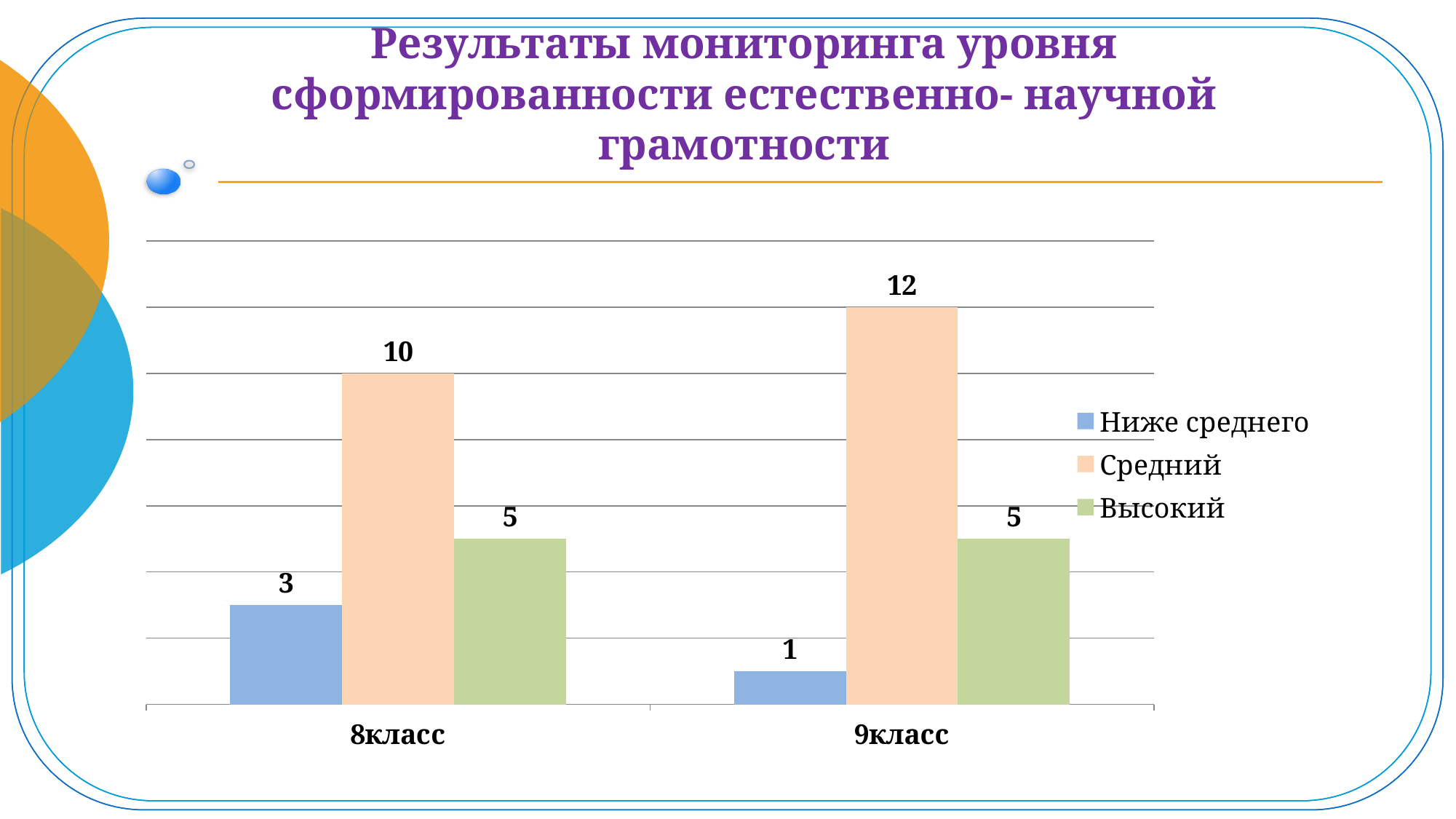
Which series has the lowest value in 8класс? Ниже среднего How many series does the legend list? 3 Which series has the highest value in 9класс? Средний What is the value for Средний in 8класс? 10 What is the difference between the Средний values for 9класс and 8класс? 2 What is the value for Высокий in 9класс? 5 How many categories are shown on the x axis? 2 What is the value for Ниже среднего in 9класс? 1 What is the value for Ниже среднего in 8класс? 3 What kind of chart is shown on the slide? Bar chart Which is larger: Ниже среднего in 8класс or Ниже среднего in 9класс? 8класс What colour are the Высокий bars? Green